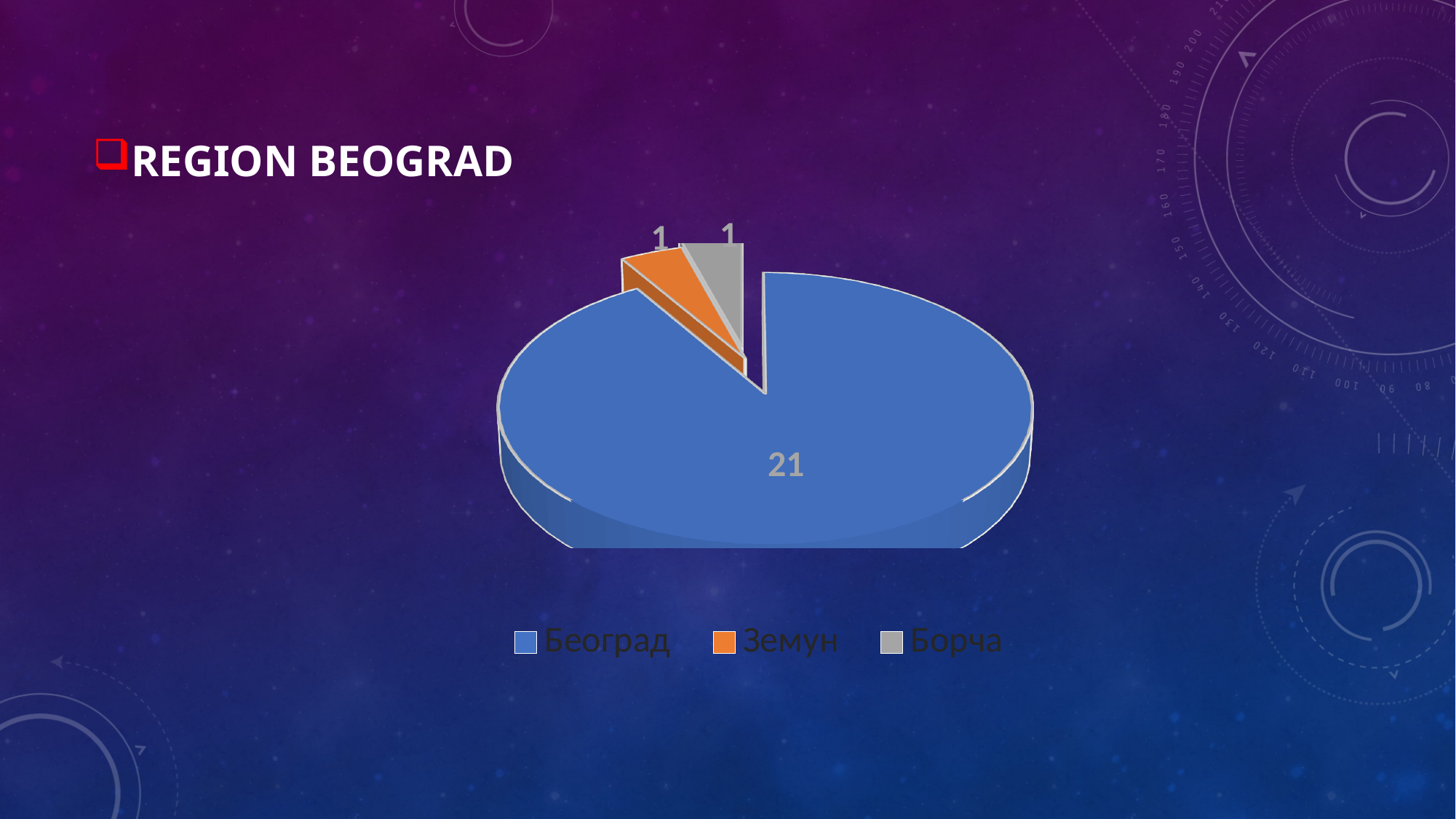
What is the total of all slices in the pie chart? 23 What colour is the slice for Земун in the pie chart? orange How many slices does the pie chart have? 3 How many entries does the legend of the pie chart list? 3 What is the difference between the values for Београд and Земун? 20 What type of chart is shown on the slide? pie chart What is the value for Београд in the pie chart? 21 What is the value for Земун in the pie chart? 1 Which category has the largest slice in the pie chart? Београд Which is larger, the value for Београд or the value for Борча? Београд Is the value for Земун larger than, smaller than, or equal to the value for Борча? equal What is the value for Борча in the pie chart? 1